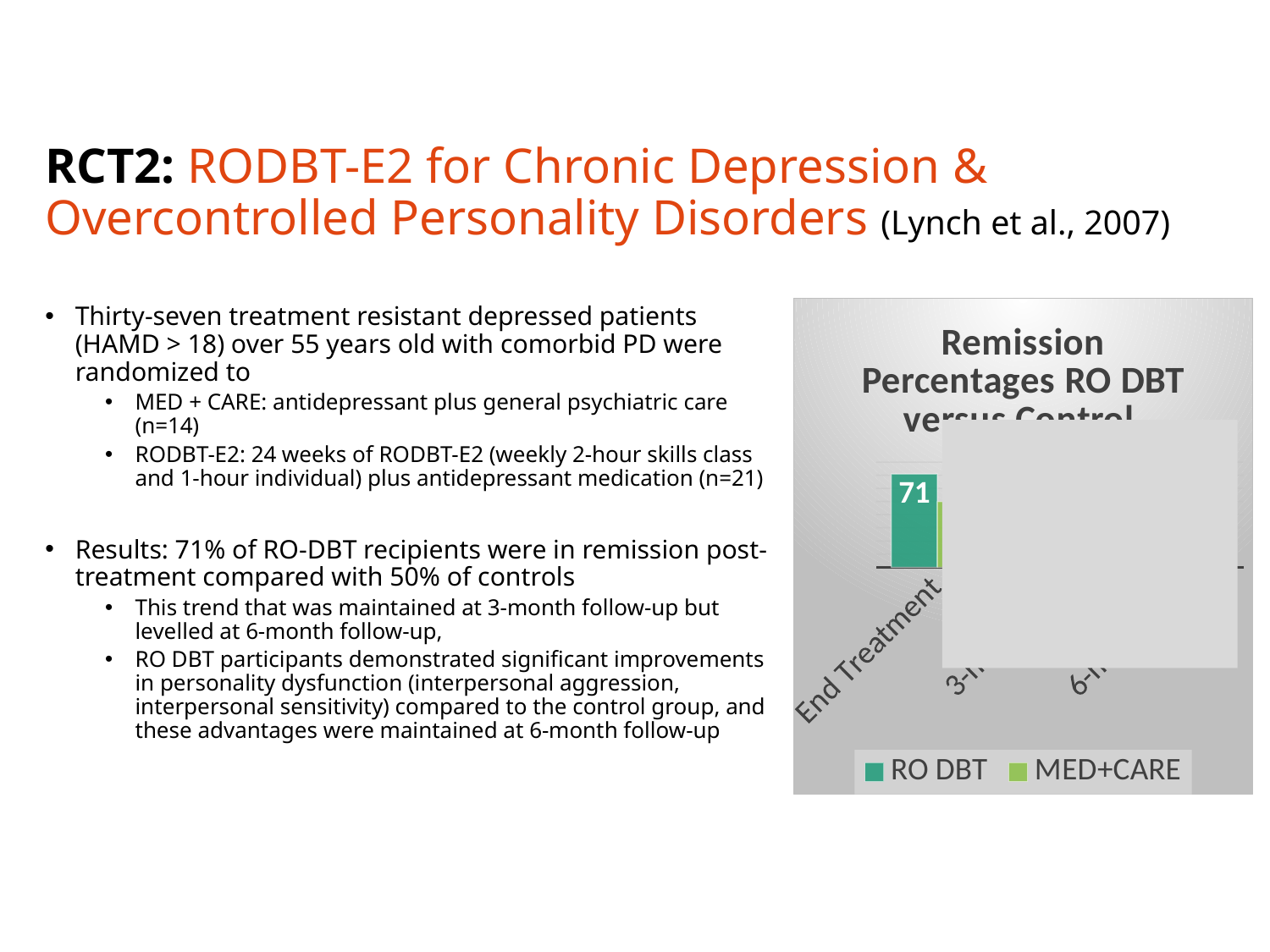
Is the value for RO DBT at End Treatment greater or less than 50? greater How many series does the chart legend list? 2 Which series has the higher value at End Treatment, RO DBT or MED+CARE? RO DBT What colour represents the RO DBT series in the chart? Green What are the two series named in the chart legend? RO DBT and MED+CARE What kind of chart is shown on the slide? Bar chart What is the remission percentage for RO DBT at End Treatment? 71